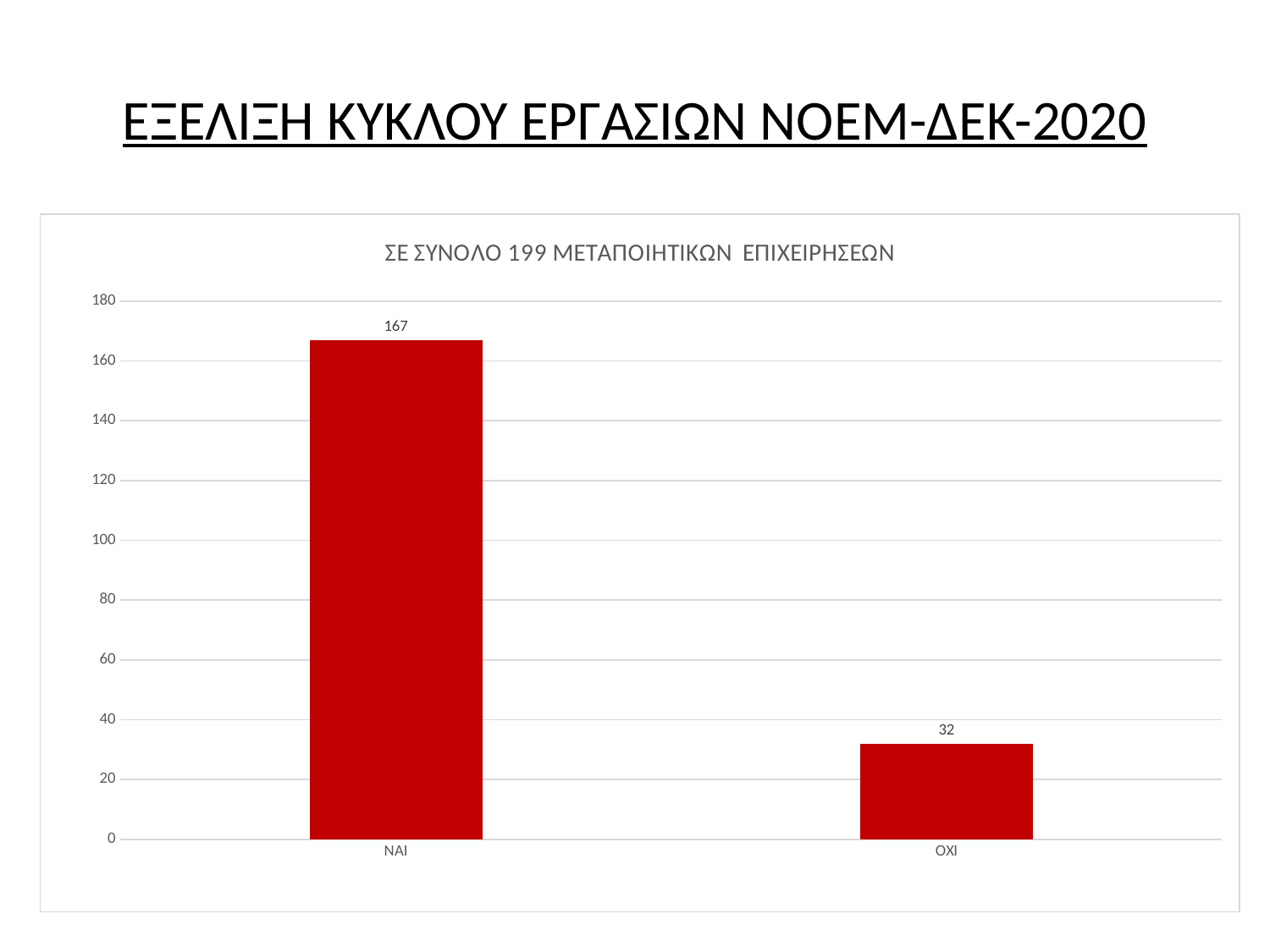
What is the value for ΝΑΙ? 167 What is the difference between the values for ΝΑΙ and ΟΧΙ? 135 Which category has the highest value? ΝΑΙ What colour are the bars in the chart? red How many categories are shown on the x axis? 2 Is the value for ΝΑΙ greater or less than 160? greater Which category has the lowest value? ΟΧΙ What kind of chart is shown on the slide? bar chart Which is larger, the value for ΝΑΙ or the value for ΟΧΙ? ΝΑΙ What is the title of the chart? ΣΕ ΣΥΝΟΛΟ 199 ΜΕΤΑΠΟΙΗΤΙΚΩΝ ΕΠΙΧΕΙΡΗΣΕΩΝ Is the value for ΟΧΙ greater or less than 40? less What is the value for ΟΧΙ? 32